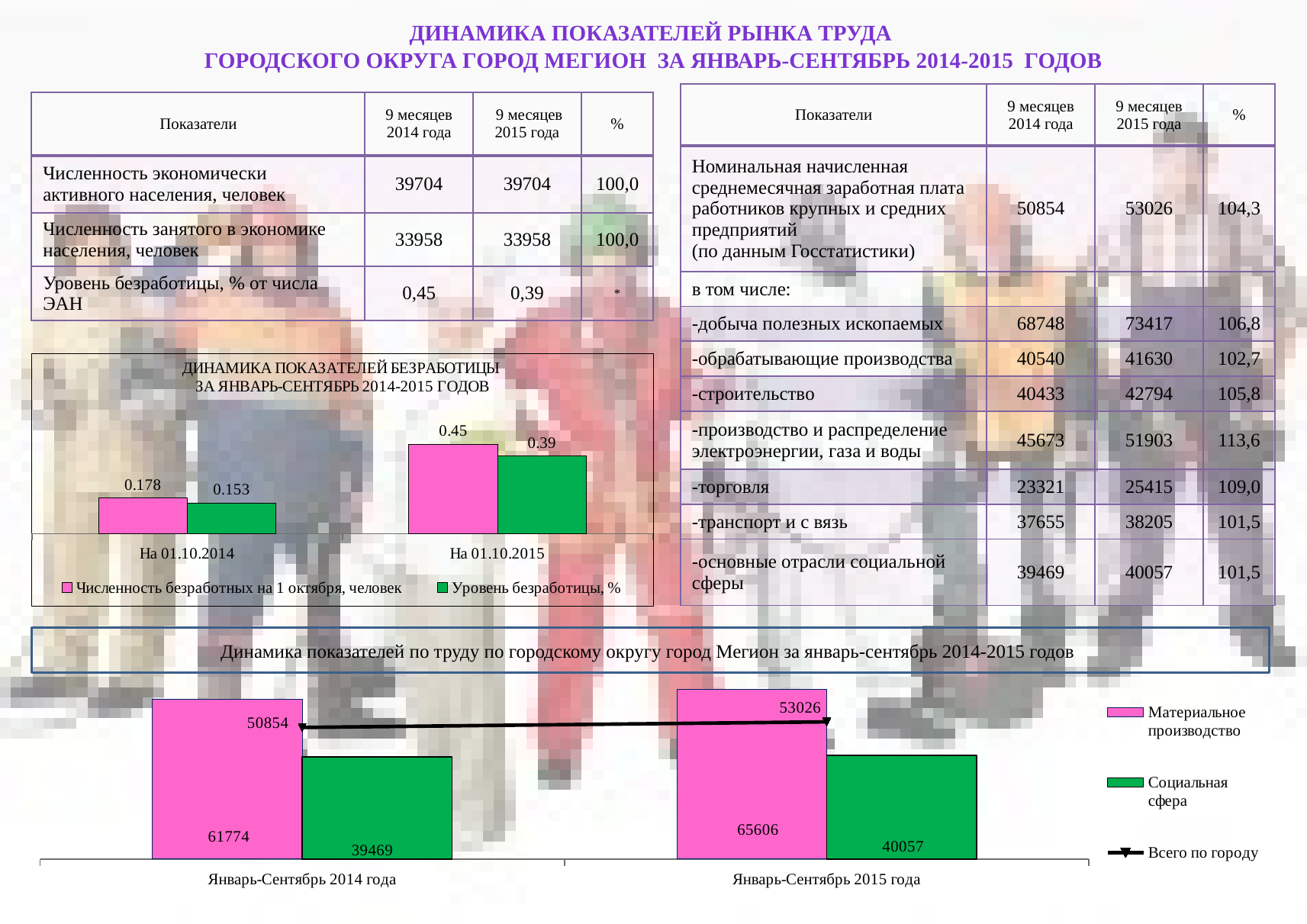
In the bottom chart 'Динамика показателей по труду по городскому округу город Мегион за январь-сентябрь 2014-2015 годов', what is the value of 'Материальное производство' for 'Январь-Сентябрь 2015 года'? 65606 In the chart titled 'ДИНАМИКА ПОКАЗАТЕЛЕЙ БЕЗРАБОТИЦЫ ЗА ЯНВАРЬ-СЕНТЯБРЬ 2014-2015 ГОДОВ', how many series does the legend list? 2 In the bottom chart 'Динамика показателей по труду по городскому округу город Мегион за январь-сентябрь 2014-2015 годов', what is the value of 'Социальная сфера' for 'Январь-Сентябрь 2014 года'? 39469 In the bottom chart 'Динамика показателей по труду по городскому округу город Мегион за январь-сентябрь 2014-2015 годов', what is the difference between 'Материальное производство' in 'Январь-Сентябрь 2015 года' and in 'Январь-Сентябрь 2014 года'? 3832 In the chart titled 'ДИНАМИКА ПОКАЗАТЕЛЕЙ БЕЗРАБОТИЦЫ ЗА ЯНВАРЬ-СЕНТЯБРЬ 2014-2015 ГОДОВ', what is the value of 'Уровень безработицы, %' for 'На 01.10.2015'? 0.39 In the bottom chart 'Динамика показателей по труду по городскому округу город Мегион за январь-сентябрь 2014-2015 годов', what colour are the 'Социальная сфера' bars? green In the bottom chart 'Динамика показателей по труду по городскому округу город Мегион за январь-сентябрь 2014-2015 годов', what is the value of 'Всего по городу' for 'Январь-Сентябрь 2015 года'? 53026 In the chart titled 'ДИНАМИКА ПОКАЗАТЕЛЕЙ БЕЗРАБОТИЦЫ ЗА ЯНВАРЬ-СЕНТЯБРЬ 2014-2015 ГОДОВ', what kind of chart is it? bar chart In the bottom chart 'Динамика показателей по труду по городскому округу город Мегион за январь-сентябрь 2014-2015 годов', which is larger for 'Январь-Сентябрь 2014 года': 'Материальное производство' or 'Социальная сфера'? Материальное производство In the chart titled 'ДИНАМИКА ПОКАЗАТЕЛЕЙ БЕЗРАБОТИЦЫ ЗА ЯНВАРЬ-СЕНТЯБРЬ 2014-2015 ГОДОВ', what is the value of 'Численность безработных на 1 октября, человек' for 'На 01.10.2014'? 0.178 In the bottom chart 'Динамика показателей по труду по городскому округу город Мегион за январь-сентябрь 2014-2015 годов', how many series does the legend list? 3 In the chart titled 'ДИНАМИКА ПОКАЗАТЕЛЕЙ БЕЗРАБОТИЦЫ ЗА ЯНВАРЬ-СЕНТЯБРЬ 2014-2015 ГОДОВ', does the 'Уровень безработицы, %' series rise or fall from 'На 01.10.2014' to 'На 01.10.2015'? rise